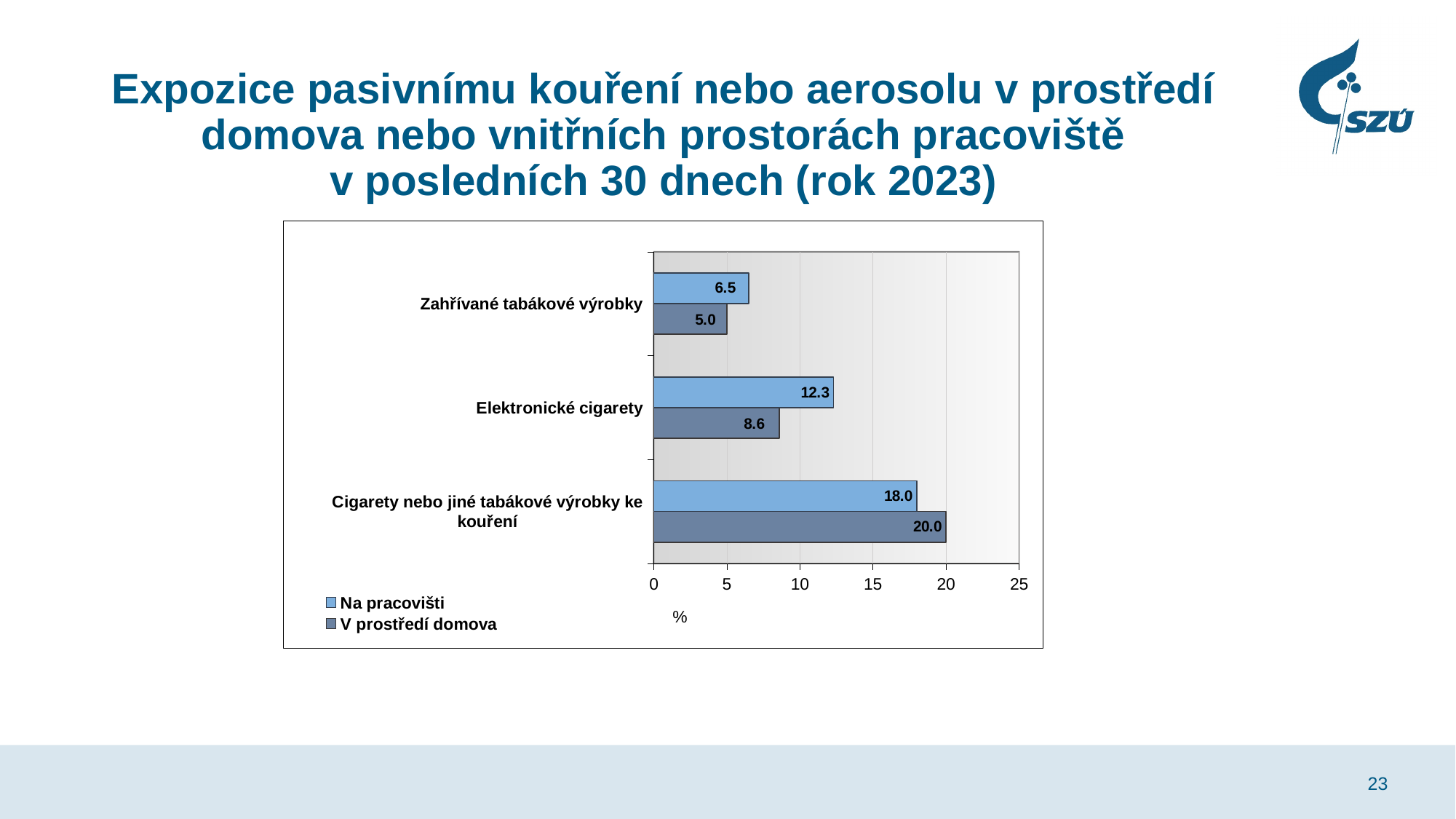
What is the value for 'Na pracovišti' for Elektronické cigarety? 12.3 Which category has the lowest value for 'V prostředí domova'? Zahřívané tabákové výrobky What is the value for 'V prostředí domova' for Zahřívané tabákové výrobky? 5.0 What unit is shown on the x axis of the chart? % For Cigarety nebo jiné tabákové výrobky ke kouření, which is larger: 'Na pracovišti' or 'V prostředí domova'? V prostředí domova How many series does the legend list? 2 What kind of chart is shown on the slide? Bar chart For Zahřívané tabákové výrobky, which is larger: 'Na pracovišti' or 'V prostředí domova'? Na pracovišti Which category has the highest value for 'Na pracovišti'? Cigarety nebo jiné tabákové výrobky ke kouření How many categories are shown on the chart? 3 What is the difference between the 'Na pracovišti' and 'V prostředí domova' values for Elektronické cigarety? 3.7 What is the value for 'V prostředí domova' for Cigarety nebo jiné tabákové výrobky ke kouření? 20.0